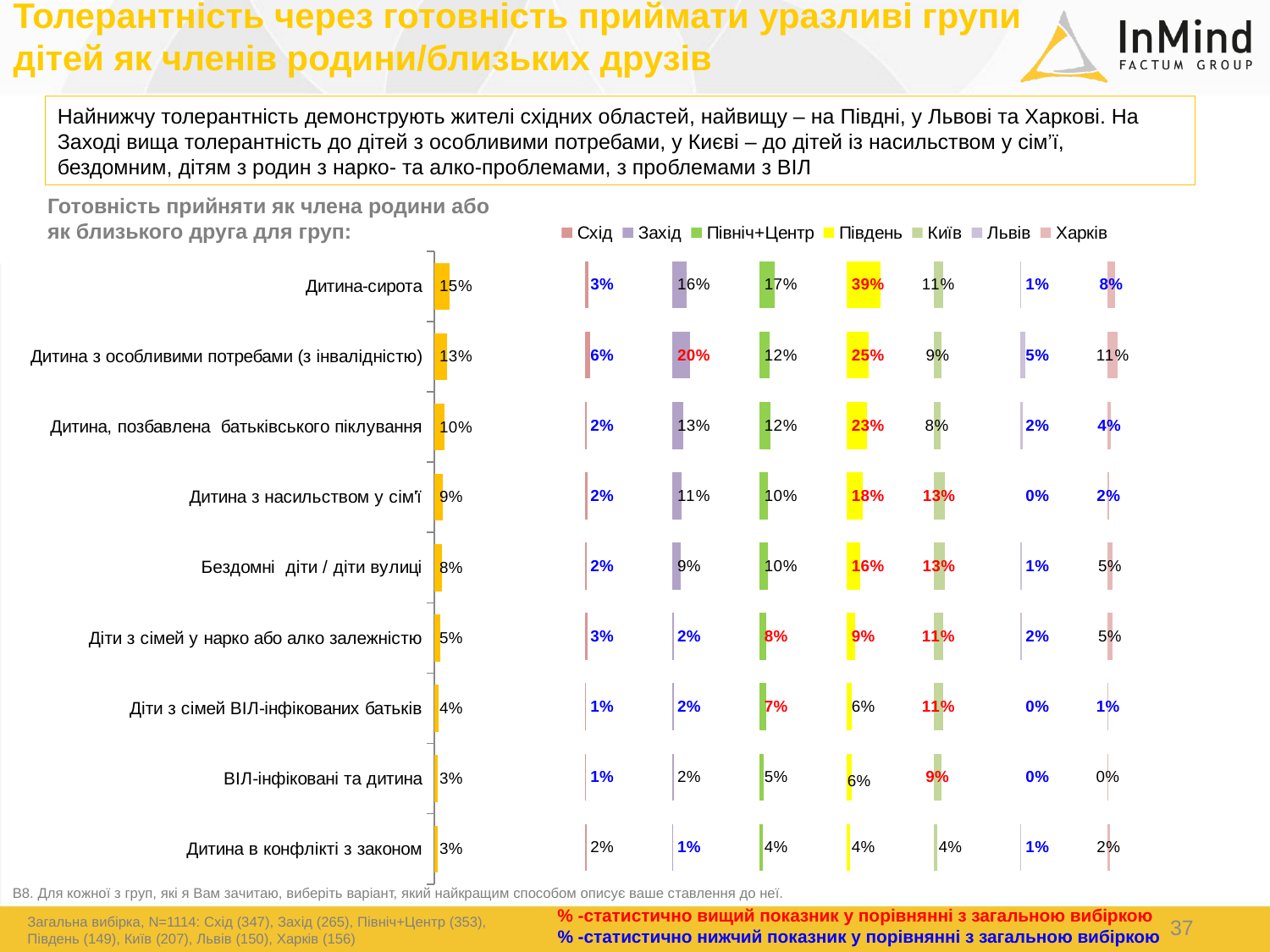
How many categories (child groups) are shown on the chart? 9 Which category has the highest value for the Південь series? Дитина-сирота What is the value for Північ+Центр for the category Діти з сімей ВІЛ-інфікованих батьків? 7% How many series does the chart legend list? 7 For the category Бездомні діти / діти вулиці, which is larger: the Київ value or the Захід value? Київ Which category has the lowest value for the Київ series? Дитина в конфлікті з законом What kind of chart is shown on the slide? Bar chart What is the value for Львів for the category Дитина з насильством у сім'ї? 0% What is the value for Південь for the category Дитина-сирота? 39% Which category has the highest value for the Харків series? Дитина з особливими потребами (з інвалідністю) What is the value for Захід for the category Дитина з особливими потребами (з інвалідністю)? 20% For the category Дитина-сирота, what is the difference between the Південь value and the Схід value? 36 percentage points